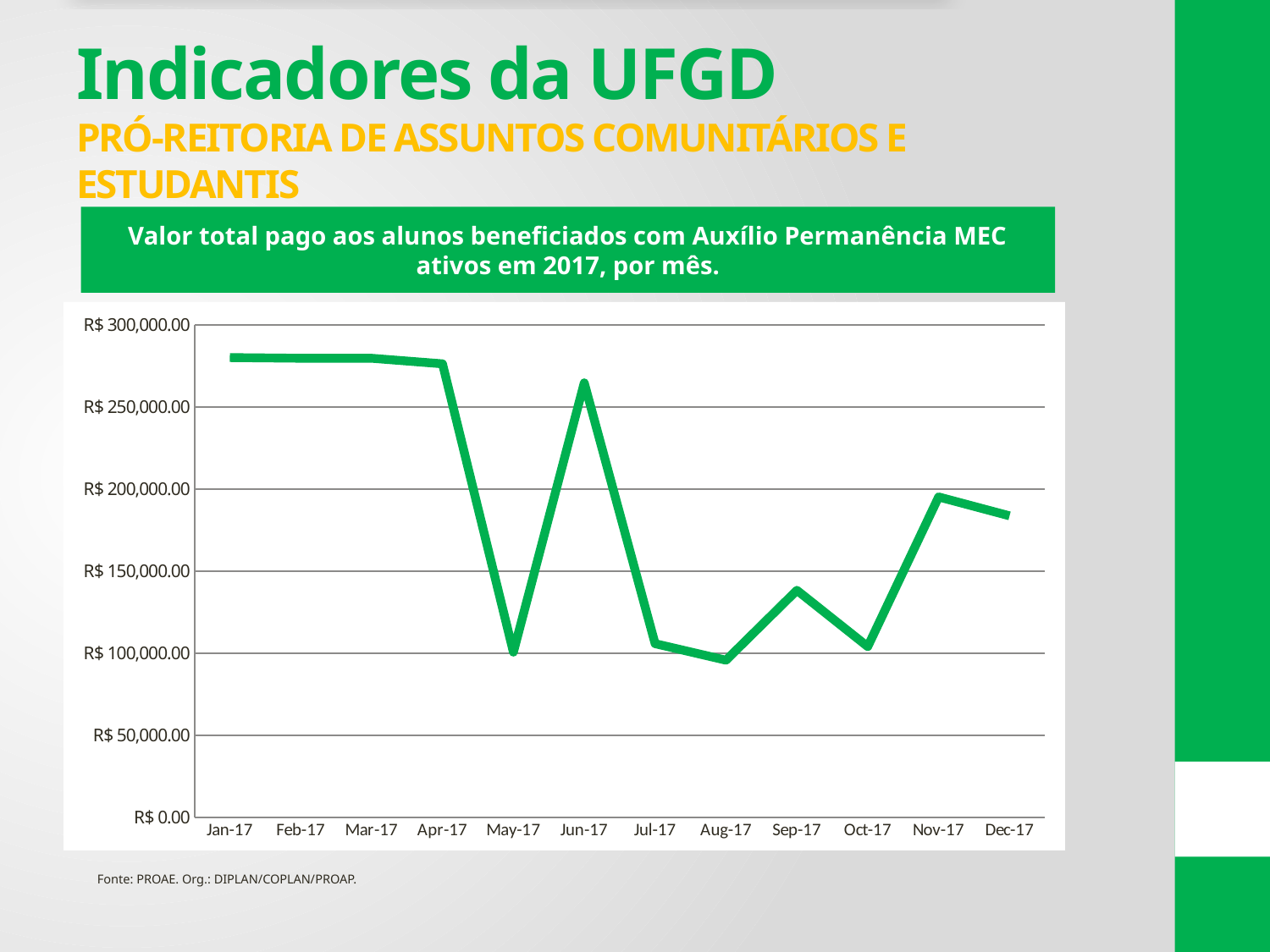
What kind of chart is shown on the slide? line chart What is the title of the chart? Valor total pago aos alunos beneficiados com Auxílio Permanência MEC ativos em 2017, por mês. Is the value for May-17 greater or less than R$ 150,000.00? less How many months are plotted on the x axis of the chart? 12 Does the value rise or fall from Apr-17 to May-17? fall Which month has the larger value, Jun-17 or Jul-17? Jun-17 Is the value for Nov-17 greater or less than R$ 150,000.00? greater Is the value for Jun-17 greater or less than R$ 250,000.00? greater Which month has the larger value, Sep-17 or Nov-17? Nov-17 Does the value rise or fall from Oct-17 to Nov-17? rise